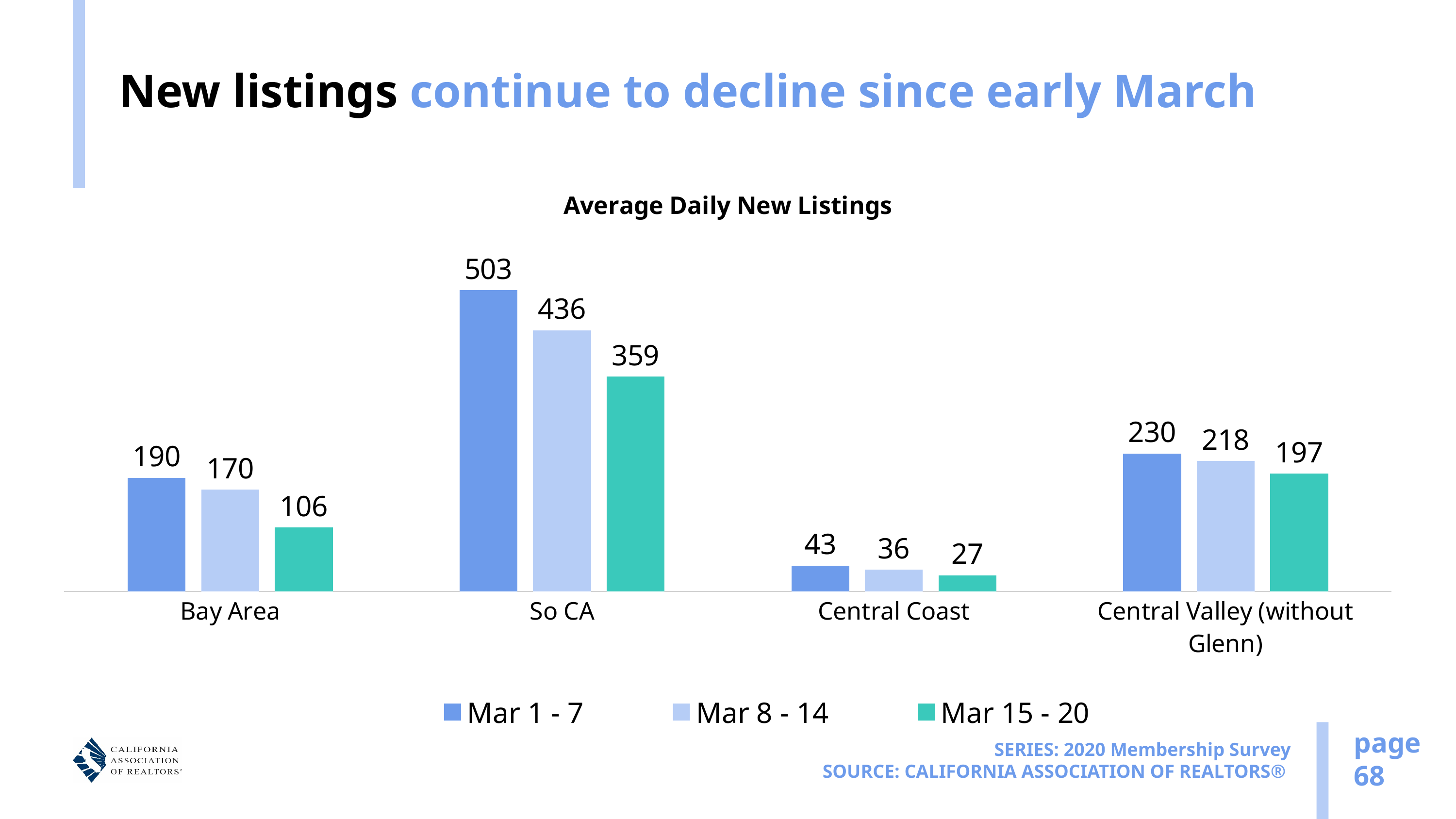
How many series does the legend list? 3 What is the value for Central Valley (without Glenn) in Mar 8 - 14? 218 What is the average daily new listings value for So CA in Mar 1 - 7? 503 How many regions are shown on the x axis? 4 What is the title of the chart? Average Daily New Listings What is the difference between the Mar 1 - 7 and Mar 8 - 14 values for Bay Area? 20 What kind of chart is shown on the slide? Bar chart Which region has the lowest value in Mar 15 - 20? Central Coast Which is larger: the Mar 15 - 20 value for Central Valley (without Glenn) or the Mar 1 - 7 value for Bay Area? Central Valley (without Glenn) Mar 15 - 20 What is the value for Bay Area in Mar 15 - 20? 106 Which region has the highest value in Mar 1 - 7? So CA What is the difference between the Mar 1 - 7 and Mar 15 - 20 values for So CA? 144